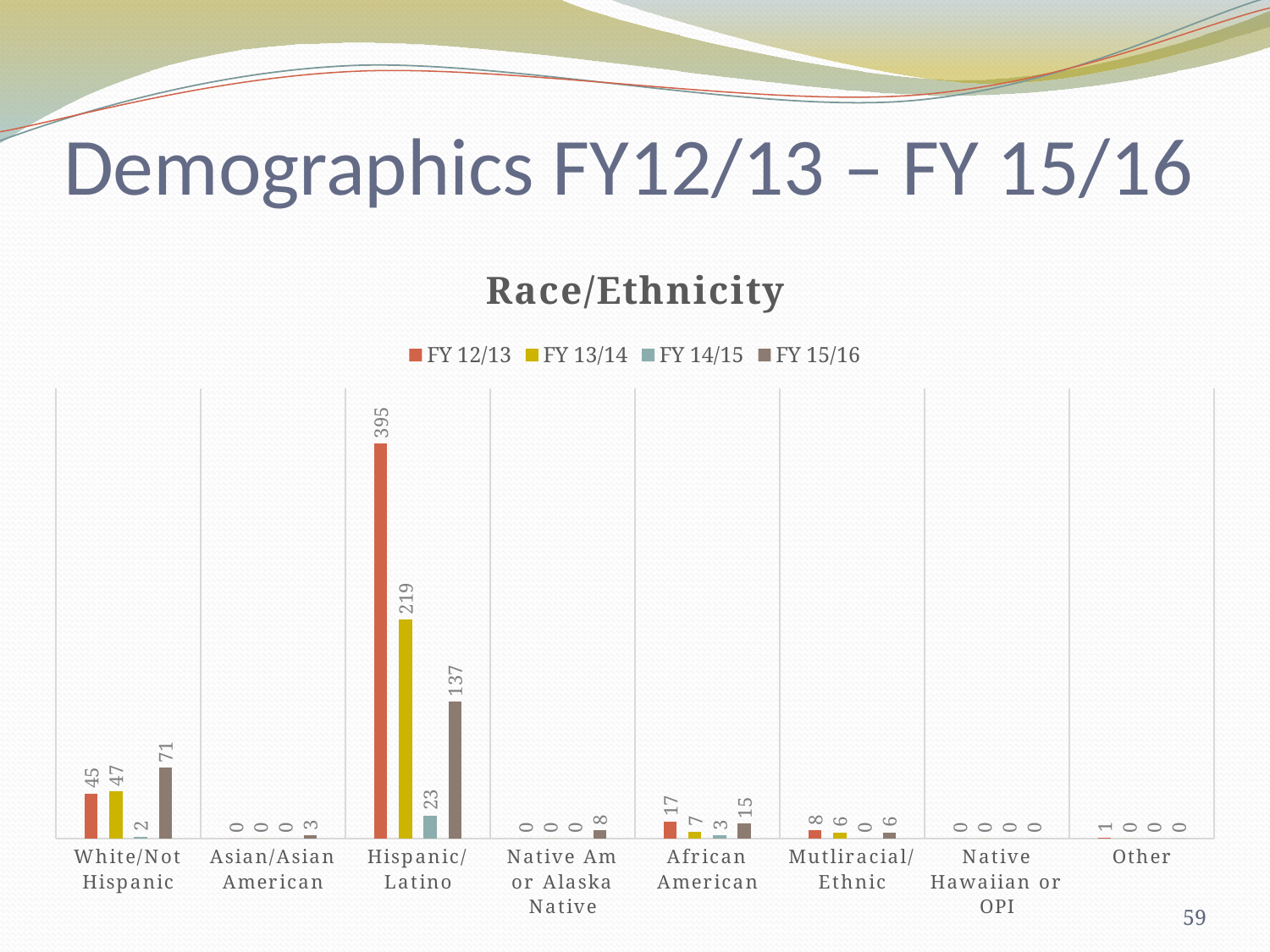
What is the FY 13/14 value for Mutliracial/Ethnic? 6 What is the FY 14/15 value for African American? 3 Which is larger for African American: the FY 12/13 value or the FY 15/16 value? FY 12/13 What is the FY 12/13 value for Hispanic/Latino? 395 How many series does the legend list? 4 Which category has the highest FY 13/14 value? Hispanic/Latino How many race/ethnicity categories are shown on the x axis? 8 What is the title of the chart? Race/Ethnicity What kind of chart is shown? Bar chart What is the difference between the FY 15/16 and FY 14/15 values for White/Not Hispanic? 69 What is the difference between the FY 12/13 and FY 13/14 values for Hispanic/Latino? 176 What is the FY 15/16 value for White/Not Hispanic? 71